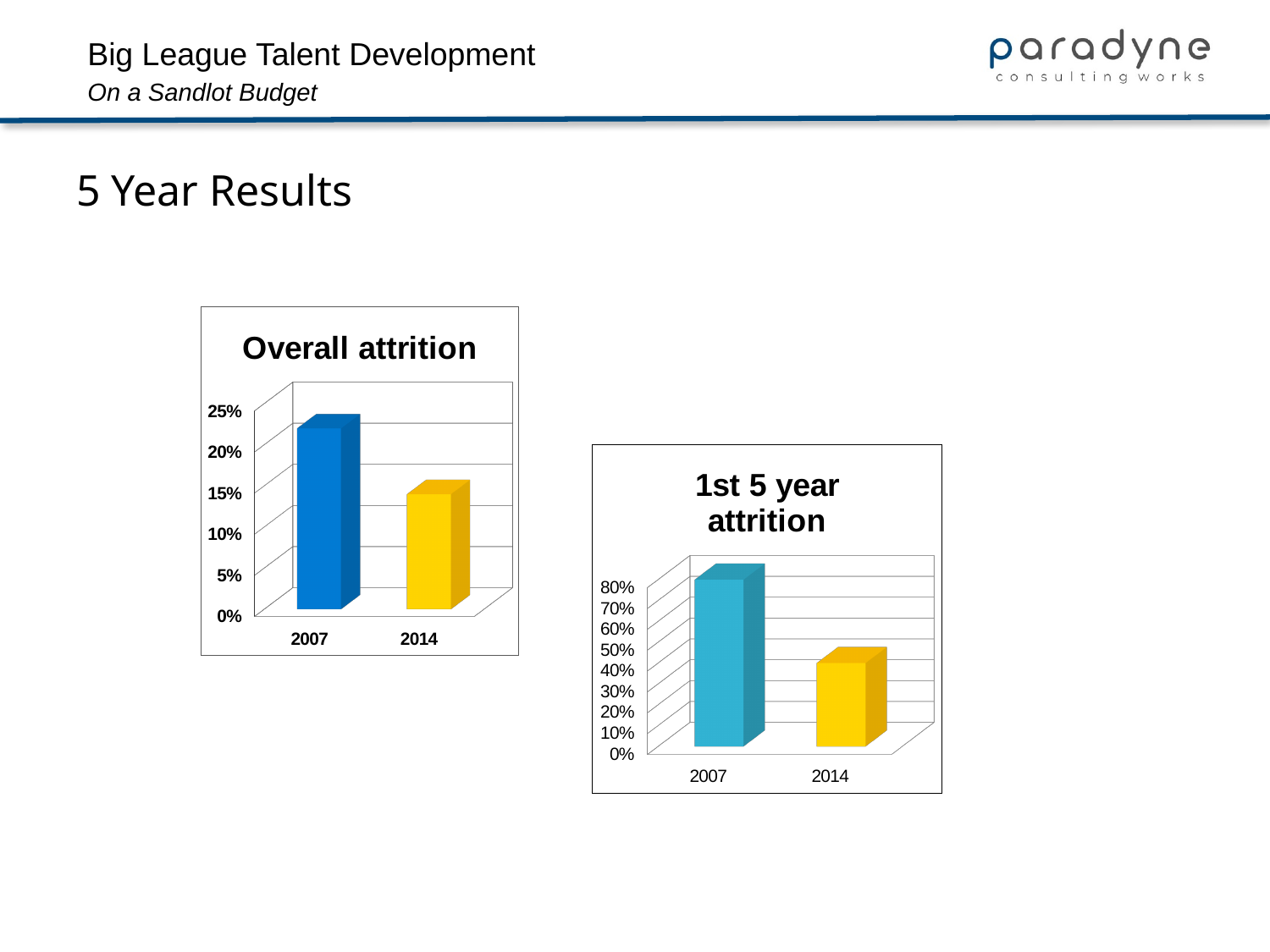
What is the title of the chart on the right side of the slide? 1st 5 year attrition In the '1st 5 year attrition' chart, is the value for 2014 greater or less than 30%? greater In the 'Overall attrition' chart, is the value for 2014 greater or less than 10%? greater In the '1st 5 year attrition' chart, is the value for 2007 greater or less than 70%? greater In the 'Overall attrition' chart, how many categories are shown on the x axis? 2 In the 'Overall attrition' chart, which year has the higher attrition? 2007 In the '1st 5 year attrition' chart, do the values rise or fall from 2007 to 2014? Fall In the 'Overall attrition' chart, which year has the lower attrition? 2014 What kind of chart is the 'Overall attrition' chart? Bar chart In the '1st 5 year attrition' chart, which year has the higher attrition? 2007